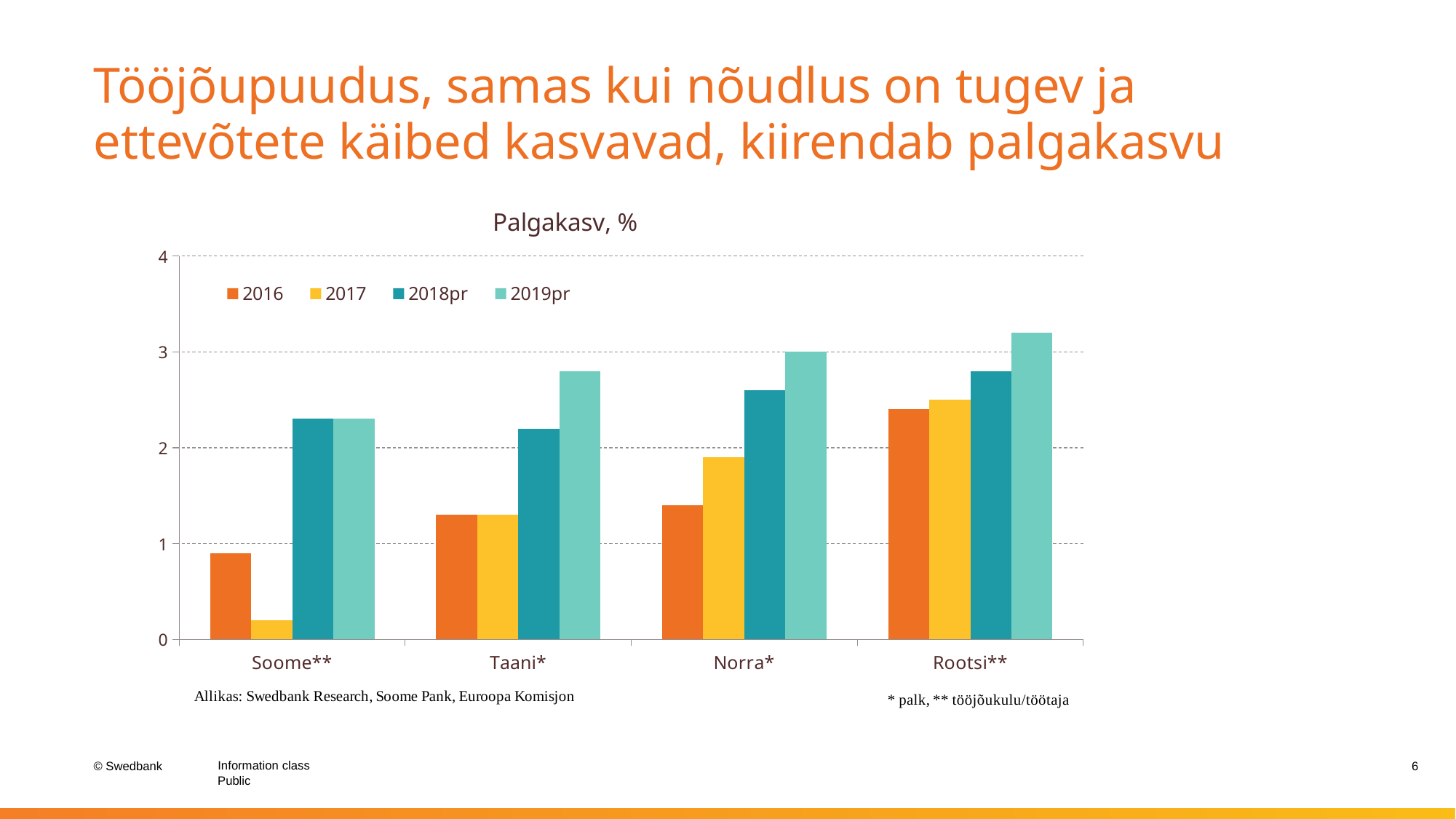
Do the values for Taani* rise or fall from 2017 to 2019pr? rise How many series does the legend list? 4 Is the 2019pr value for Rootsi** greater or less than 3? greater How many countries are shown on the x axis of the chart? 4 Is the 2018pr value for Taani* greater or less than 2? greater What is the title of the chart? Palgakasv, % Is the 2017 value for Soome** greater or less than 1? less What kind of chart is shown on the slide? bar chart Which series is shown in orange in the legend? 2016 Which country has the lowest 2017 value? Soome** Which is larger for Norra*: the 2016 value or the 2018pr value? 2018pr Which country has the highest 2019pr value? Rootsi**